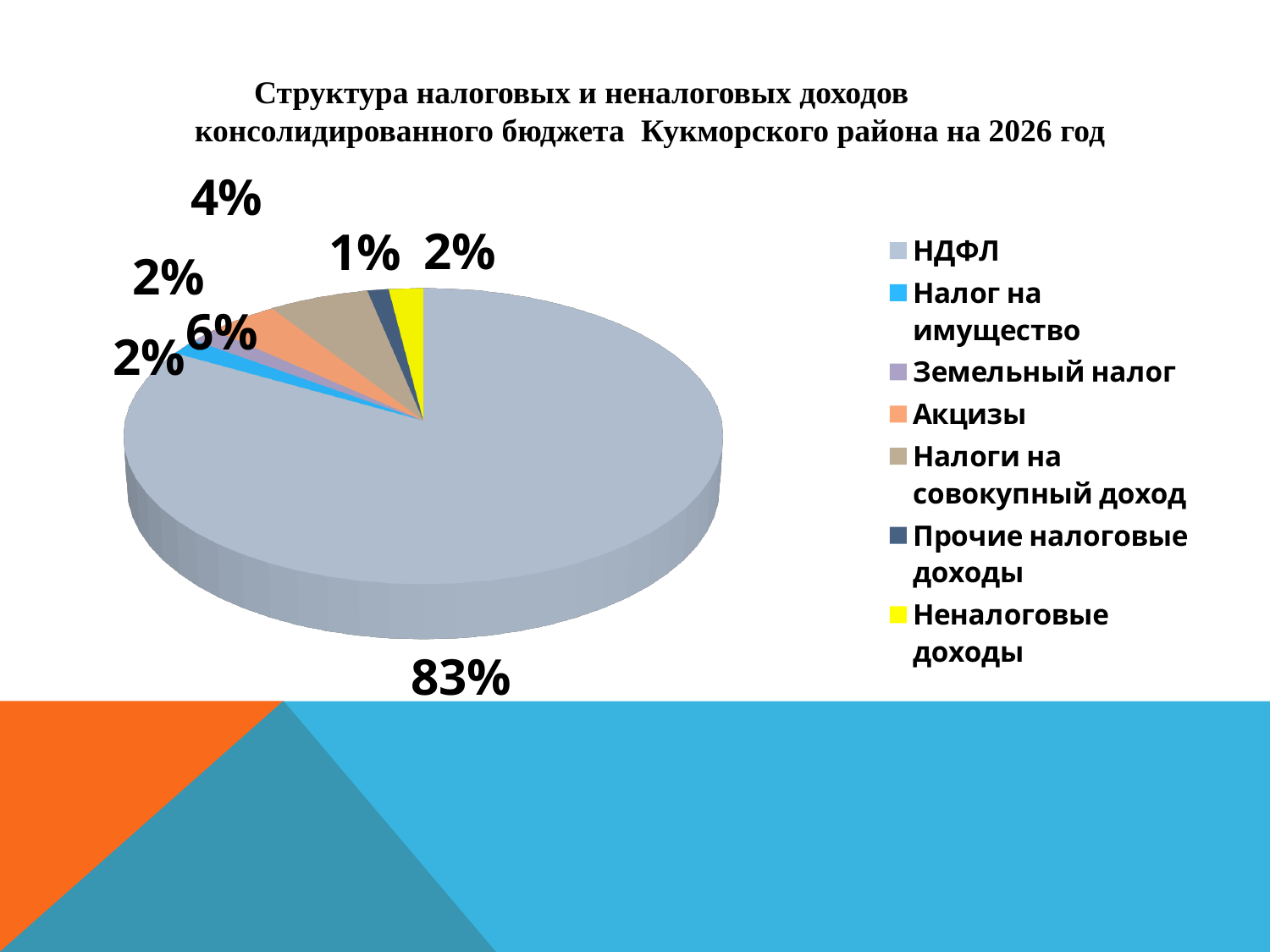
Which category has the largest slice of the pie? НДФЛ What share of the pie does Неналоговые доходы account for? 2% Is the share for НДФЛ greater or less than 50%? greater What kind of chart is shown on the slide? pie chart What share of the pie does Прочие налоговые доходы account for? 1% What year does the chart title refer to? 2026 Which is larger, the share for НДФЛ or the share for Неналоговые доходы? НДФЛ How many categories does the legend of the pie chart list? 7 What colour is the slice for Неналоговые доходы? yellow What share of the pie does НДФЛ account for? 83% Which category has the smallest slice of the pie? Прочие налоговые доходы By how many percentage points does the share of НДФЛ exceed the share of Прочие налоговые доходы? 82 percentage points